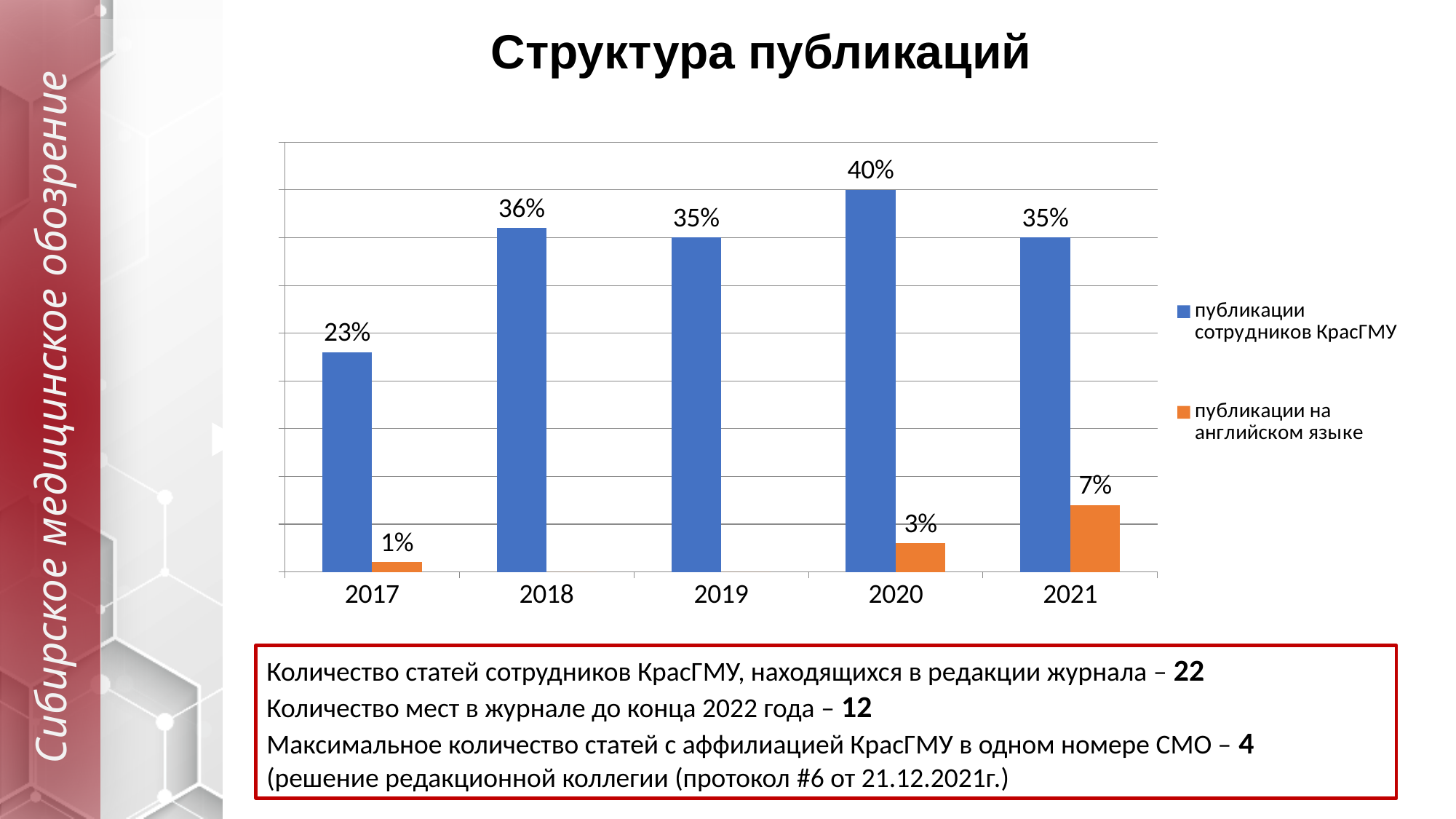
What is the value for публикации на английском языке in 2020? 3% How many series does the legend list? 2 In which year is the value for публикации сотрудников КрасГМУ the lowest? 2017 What is the value for публикации на английском языке in 2021? 7% What is the value for публикации сотрудников КрасГМУ in 2017? 23% Which is larger: публикации сотрудников КрасГМУ in 2018 or in 2019? 2018 What is the value for публикации сотрудников КрасГМУ in 2020? 40% How many years are shown on the x axis? 5 In which year is the value for публикации сотрудников КрасГМУ the highest? 2020 What kind of chart is shown on the slide? Bar chart What is the difference between the публикации сотрудников КрасГМУ values for 2020 and 2017? 17% What colour are the bars for публикации на английском языке? Orange